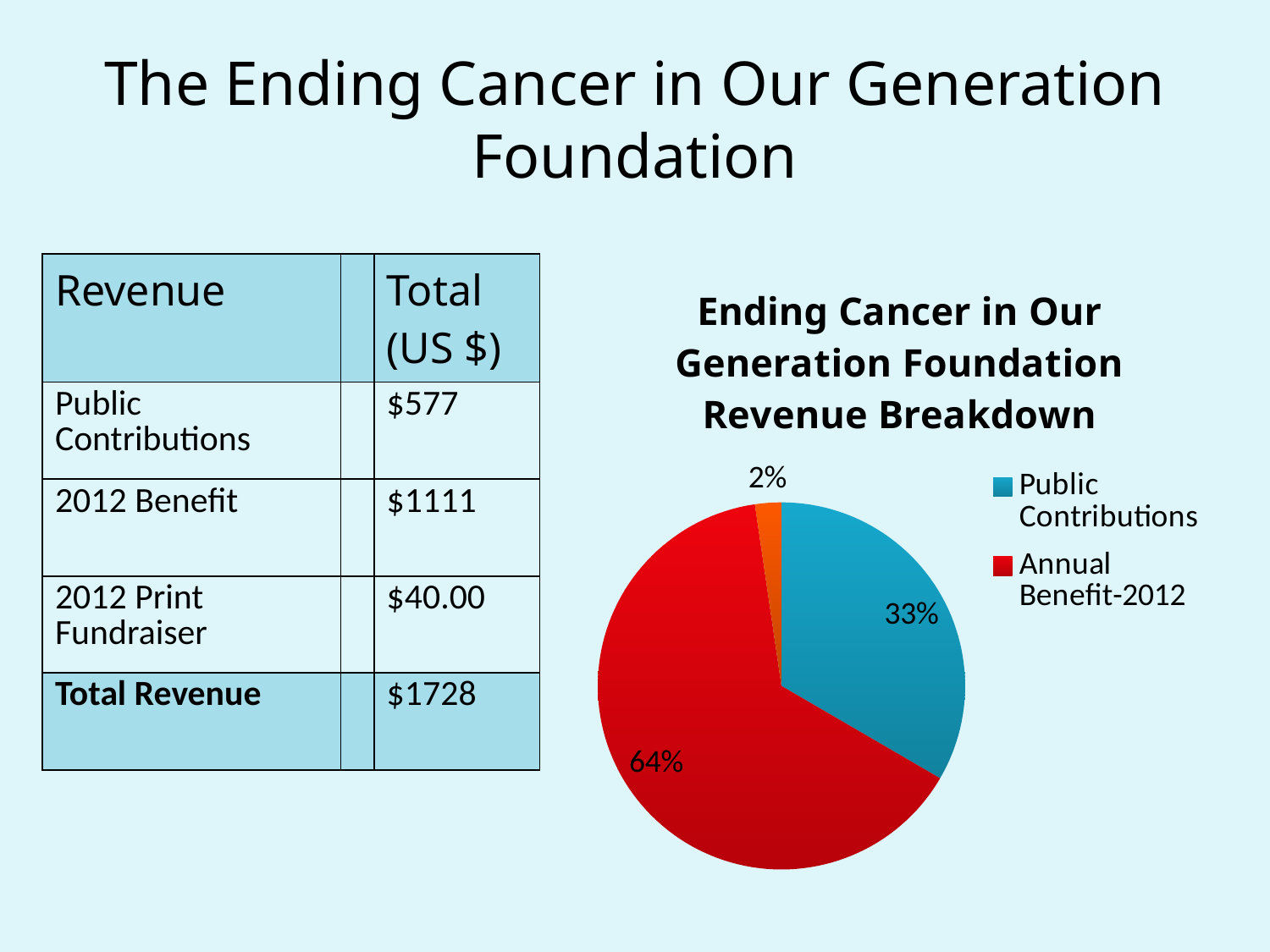
What colour represents Annual Benefit-2012 in the pie chart? red Which slice of the pie chart is the largest? Annual Benefit-2012 What percentage of the pie chart is Public Contributions? 33% By how many percentage points does the Annual Benefit-2012 slice exceed the Public Contributions slice? 31 percentage points Is the Public Contributions share of the pie chart greater or less than 50%? less How many slices does the pie chart have? 3 What is the title of the pie chart? Ending Cancer in Our Generation Foundation Revenue Breakdown What percentage of the pie chart is Annual Benefit-2012? 64% What is the smallest percentage labelled on the pie chart? 2% What type of chart is shown on the slide? pie chart How many entries does the pie chart's legend list? 2 Which is larger in the pie chart, Public Contributions or Annual Benefit-2012? Annual Benefit-2012